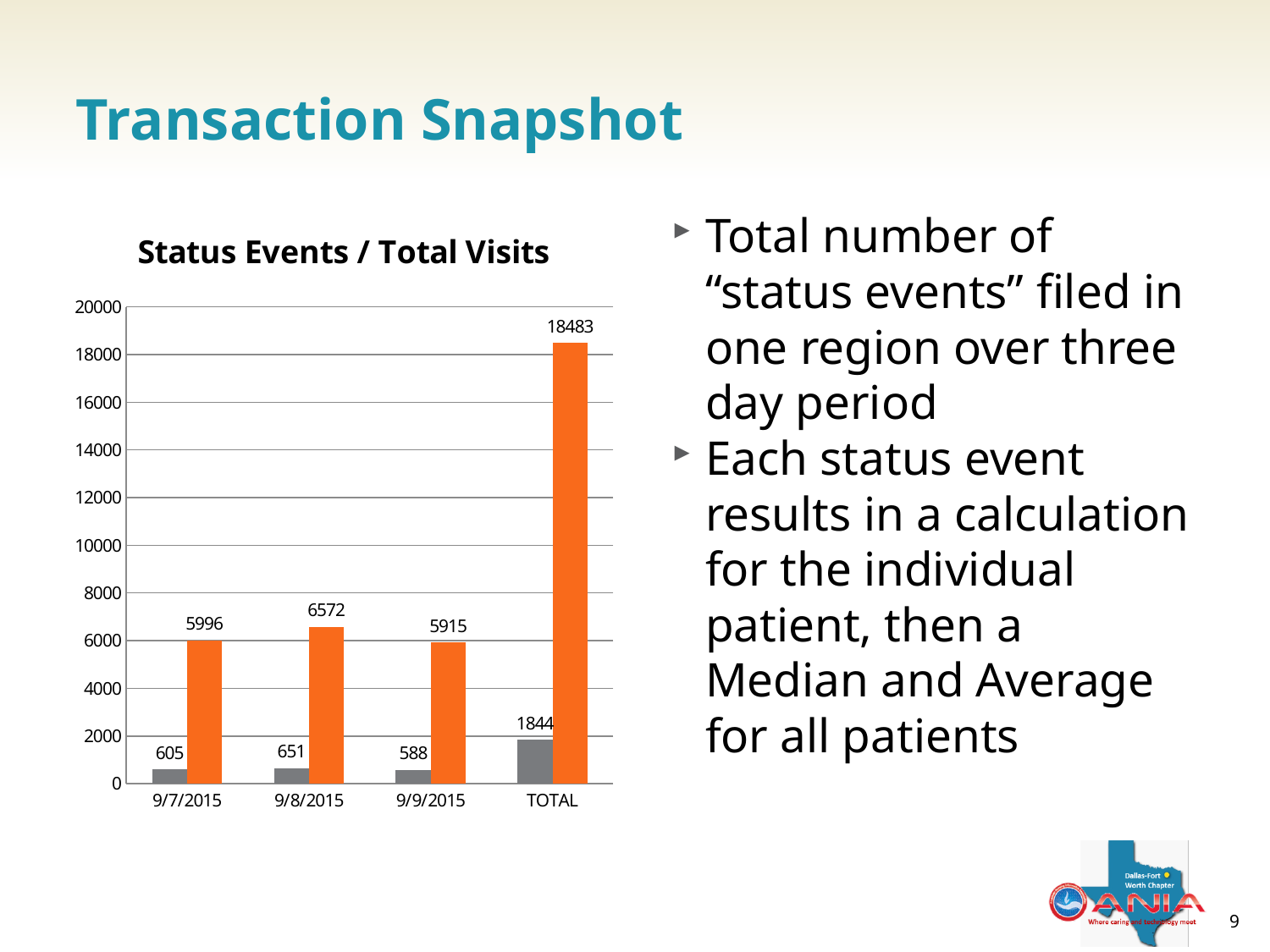
Is the orange bar for 9/9/2015 greater or less than 8000? less What is the value of the orange bar for 9/8/2015? 6572 What is the value of the gray bar for 9/7/2015? 605 What is the value of the orange bar for TOTAL? 18483 What type of chart is shown on the slide? bar chart How many categories are shown on the x axis of the chart? 4 What is the value of the gray bar for 9/9/2015? 588 Among the three dates, which date has the highest orange bar? 9/8/2015 Which is larger, the gray bar for 9/8/2015 or the gray bar for 9/7/2015? 9/8/2015 What is the title of the chart? Status Events / Total Visits What is the difference between the orange bar values for 9/8/2015 and 9/7/2015? 576 Among the three dates, which date has the lowest gray bar? 9/9/2015